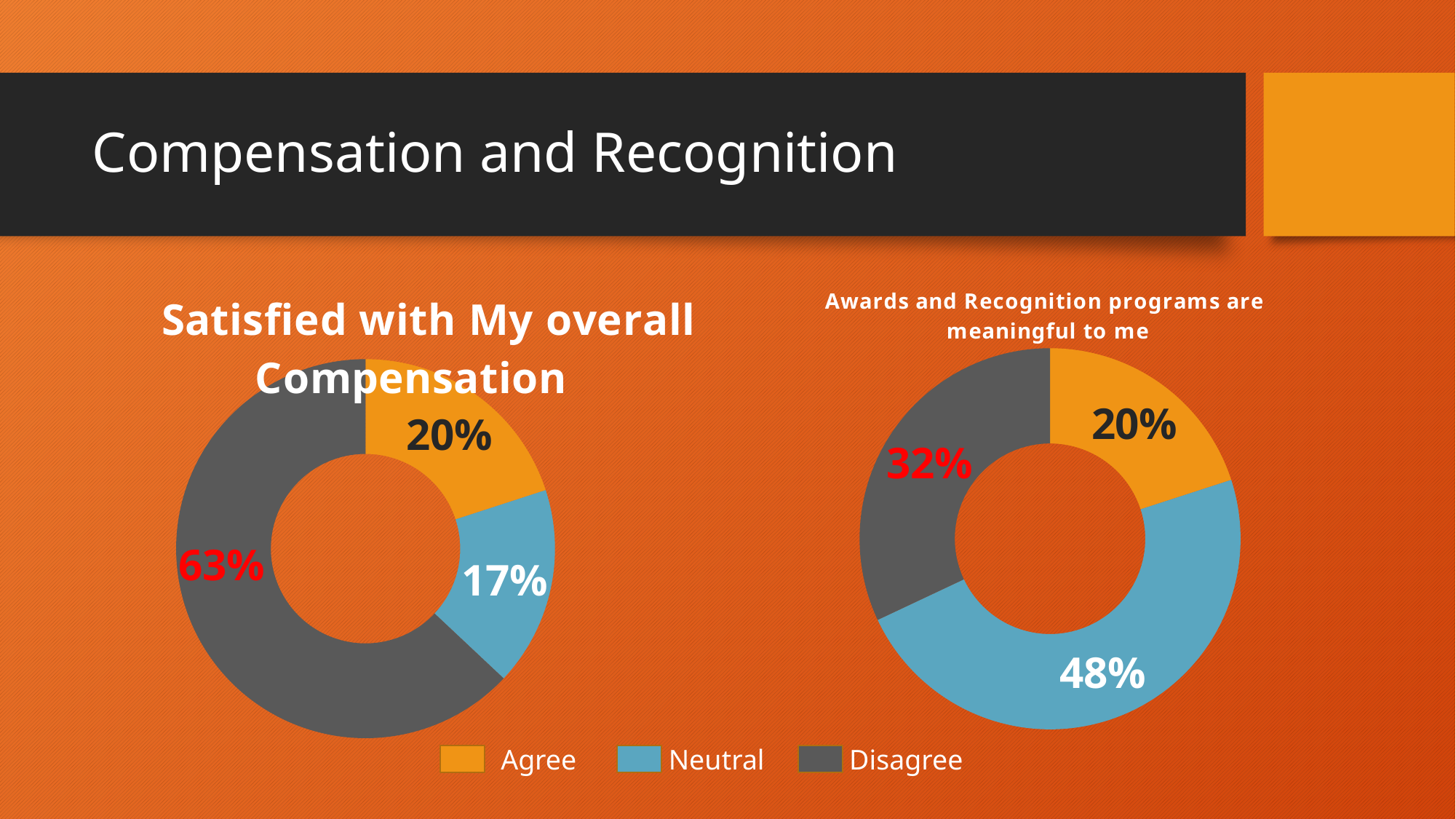
How many categories does the legend list for the charts on this slide? 3 In the 'Awards and Recognition programs are meaningful to me' chart, what is the combined share of Agree and Neutral? 68% What type of chart is the 'Satisfied with My overall Compensation' chart? Doughnut chart In the 'Awards and Recognition programs are meaningful to me' chart, which category has the smallest share? Agree In the 'Satisfied with My overall Compensation' chart, what percentage is shown for Neutral? 17% In the 'Satisfied with My overall Compensation' chart, what percentage is shown for Disagree? 63% In the 'Satisfied with My overall Compensation' chart, what is the difference between the Disagree and Agree percentages? 43% In the 'Satisfied with My overall Compensation' chart, which category has the largest share? Disagree In the 'Awards and Recognition programs are meaningful to me' chart, what percentage is shown for Neutral? 48% In the 'Awards and Recognition programs are meaningful to me' chart, what percentage is shown for Disagree? 32% In the 'Awards and Recognition programs are meaningful to me' chart, is the Neutral share larger or smaller than the Disagree share? larger Which colour represents Neutral in the legend? Blue